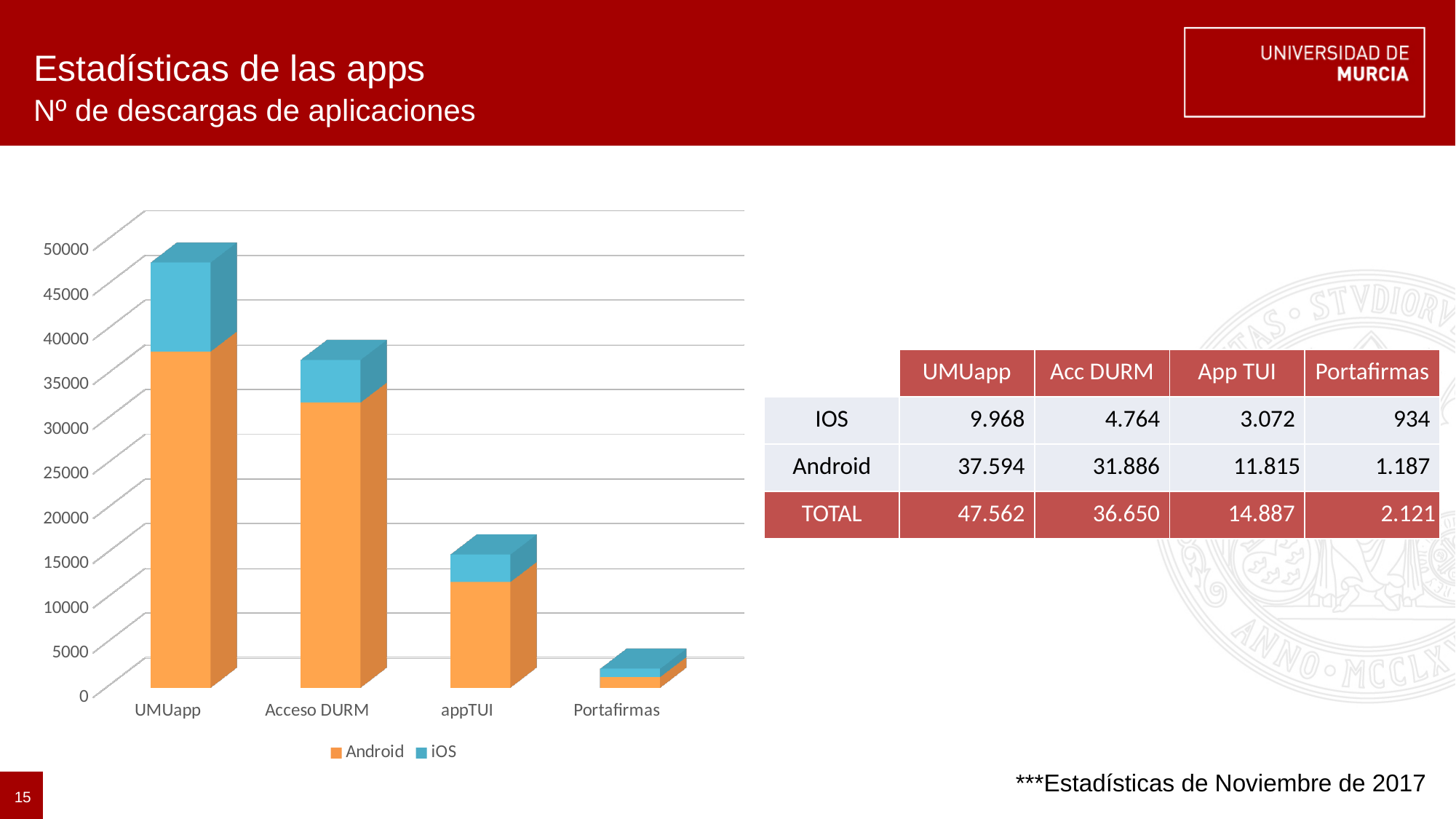
How many categories are shown on the x axis of the chart? 4 Which category has the shortest stacked bar in the chart? Portafirmas Which series are listed in the chart legend? Android and iOS What kind of chart is shown on the slide? Stacked bar chart Which category has the tallest stacked bar in the chart? UMUapp Do the stacked bar totals rise or fall from left to right across the x axis? fall According to the table on the slide, how many Android downloads does UMUapp have? 37.594 How many series does the chart legend list? 2 Which is larger, the Android segment for UMUapp or the Android segment for Acceso DURM? UMUapp According to the table on the slide, what is the total number of downloads for Portafirmas? 2.121 Is the total bar for appTUI greater or less than 20000? less Is the total bar for Acceso DURM greater or less than 35000? greater